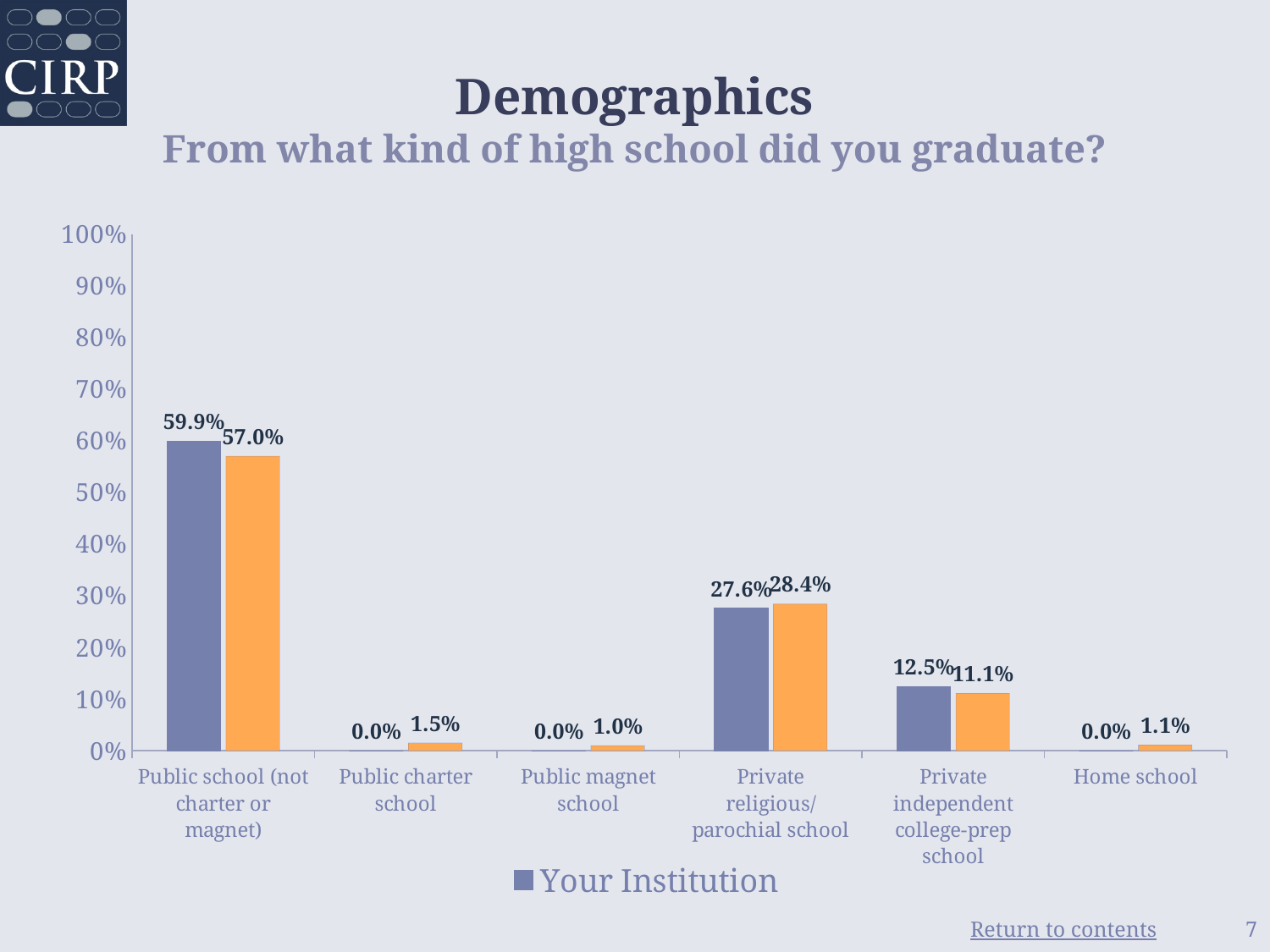
What is the value for Your Institution for Public school (not charter or magnet)? 59.9% What is the value shown by the orange bar for Public charter school? 1.5% What is the difference between the Your Institution value and the orange bar value for Public school (not charter or magnet)? 2.9% For Private religious/parochial school, which is larger: the Your Institution value or the orange bar value? the orange bar value What is the value shown by the orange bar for Home school? 1.1% What kind of chart is shown on the slide? bar chart Is the Your Institution value for Public school (not charter or magnet) greater or less than 50%? greater What series name is listed in the legend? Your Institution Which category has the highest value for Your Institution? Public school (not charter or magnet) What is the value for Your Institution for Private independent college-prep school? 12.5% What is the value for Your Institution for Private religious/parochial school? 27.6% How many categories are shown on the x axis? 6